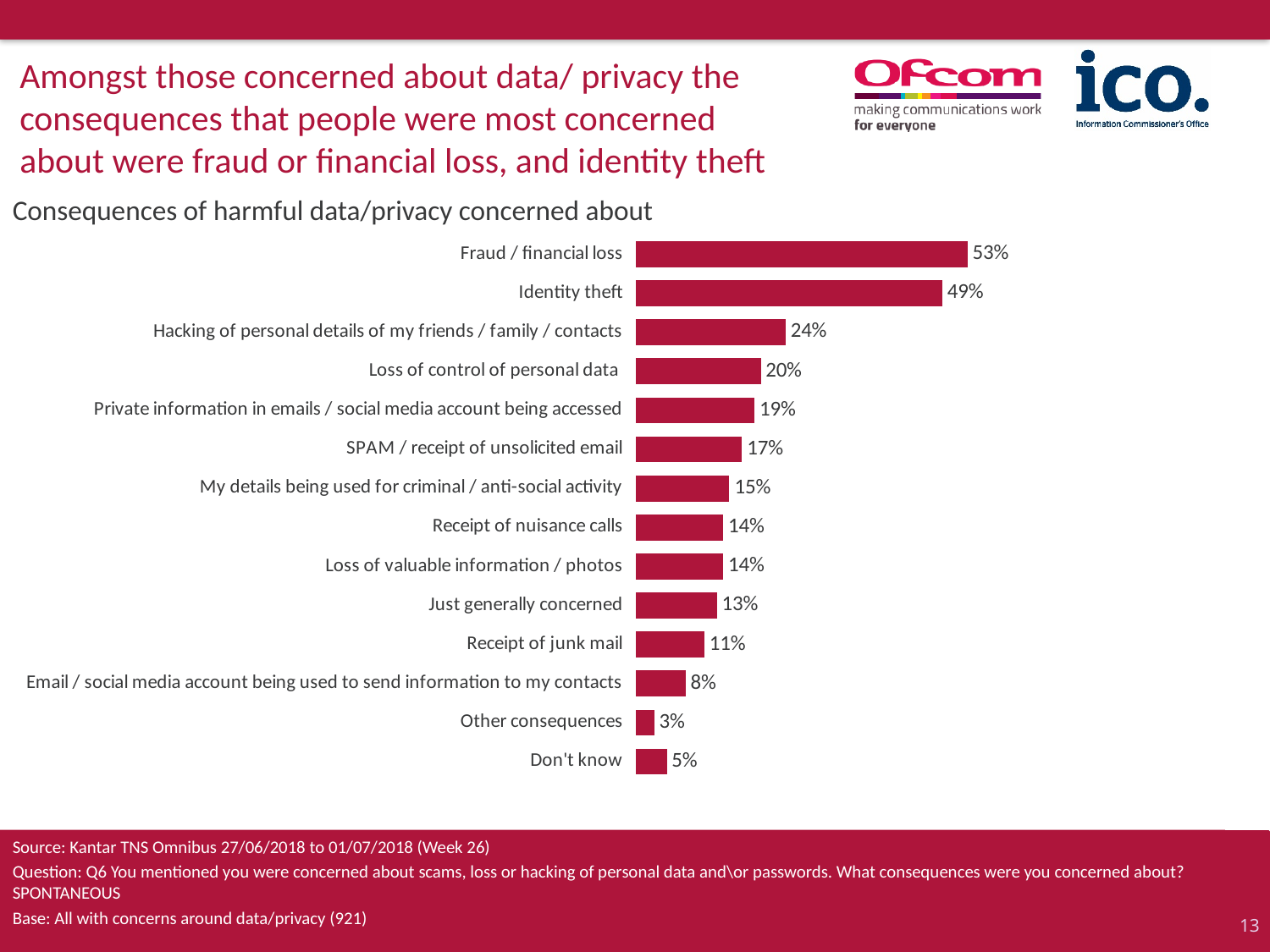
What percentage is shown for receipt of junk mail? 11% Which is larger: the value for Don't know or the value for Other consequences? Don't know What is the difference in percentage points between fraud / financial loss and identity theft? 4 Which is larger: the value for SPAM / receipt of unsolicited email or the value for receipt of nuisance calls? SPAM / receipt of unsolicited email What is the value shown for identity theft? 49% What is the title of the chart? Consequences of harmful data/privacy concerned about How many categories are shown in the chart? 14 What is the difference in percentage points between hacking of personal details of my friends / family / contacts and loss of control of personal data? 4 Which consequence has the highest percentage? Fraud / financial loss What type of chart is shown on the slide? Bar chart Which consequence has the lowest percentage? Other consequences What percentage of respondents were concerned about fraud / financial loss? 53%